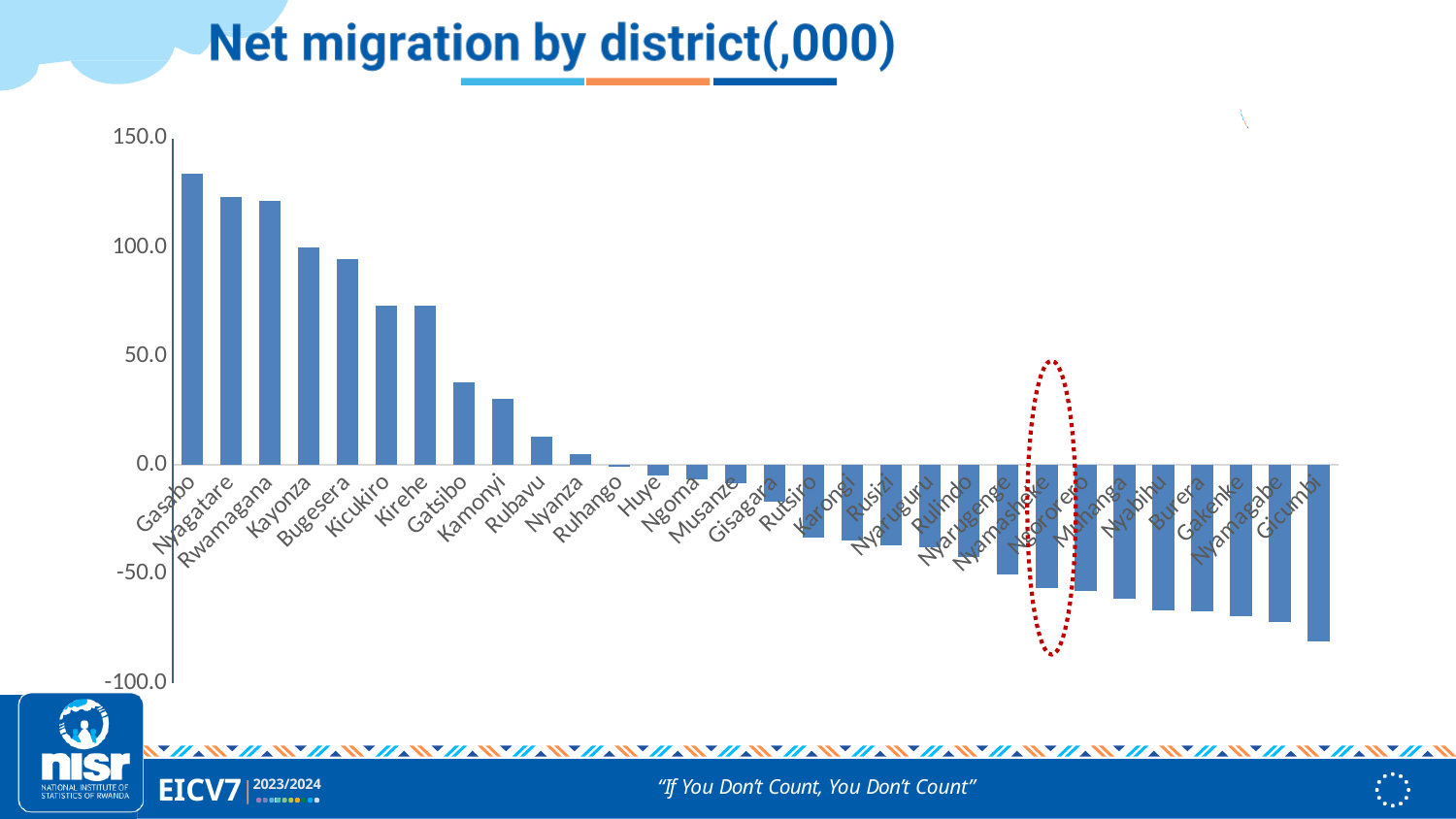
Which district's bar is highlighted with a red dotted circle? Nyamasheke Which district has the highest net migration? Gasabo Is the value for Gicumbi greater or less than -50.0? less How many districts are plotted in the chart? 30 Do the values rise or fall moving from left to right along the x axis? Fall What is the title of the chart? Net migration by district(,000) Which district has the lowest net migration? Gicumbi What type of chart is shown on the slide? Bar chart Is the value for Gasabo greater or less than 100.0? greater Which has a higher net migration, Gasabo or Nyagatare? Gasabo Is the value for Rubavu greater or less than 50.0? less